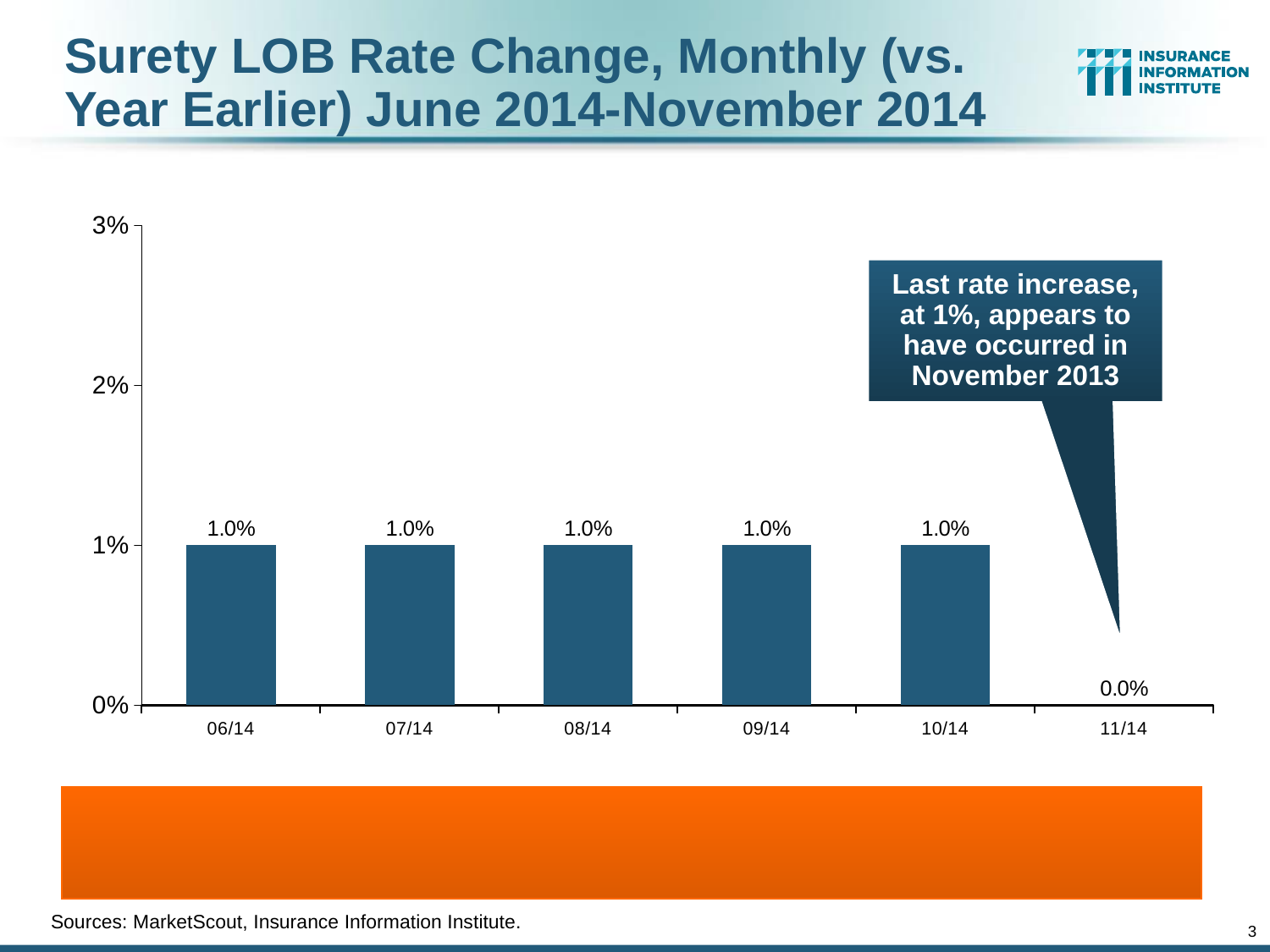
What is the rate change value for 06/14? 1.0% According to the callout on the chart, when did the last rate increase appear to occur? November 2013 What kind of chart is shown on the slide? bar chart Is the value for 07/14 greater or less than 2%? less Which month has the lowest rate change? 11/14 What is the rate change value for 09/14? 1.0% Which is larger, the value for 08/14 or the value for 11/14? 08/14 Do the values rise, fall, or stay flat from 06/14 to 10/14? stay flat What is the rate change value for 11/14? 0.0% What is the difference between the values for 10/14 and 11/14? 1.0% What is the highest value shown on the y axis? 3% How many months are shown on the x axis? 6